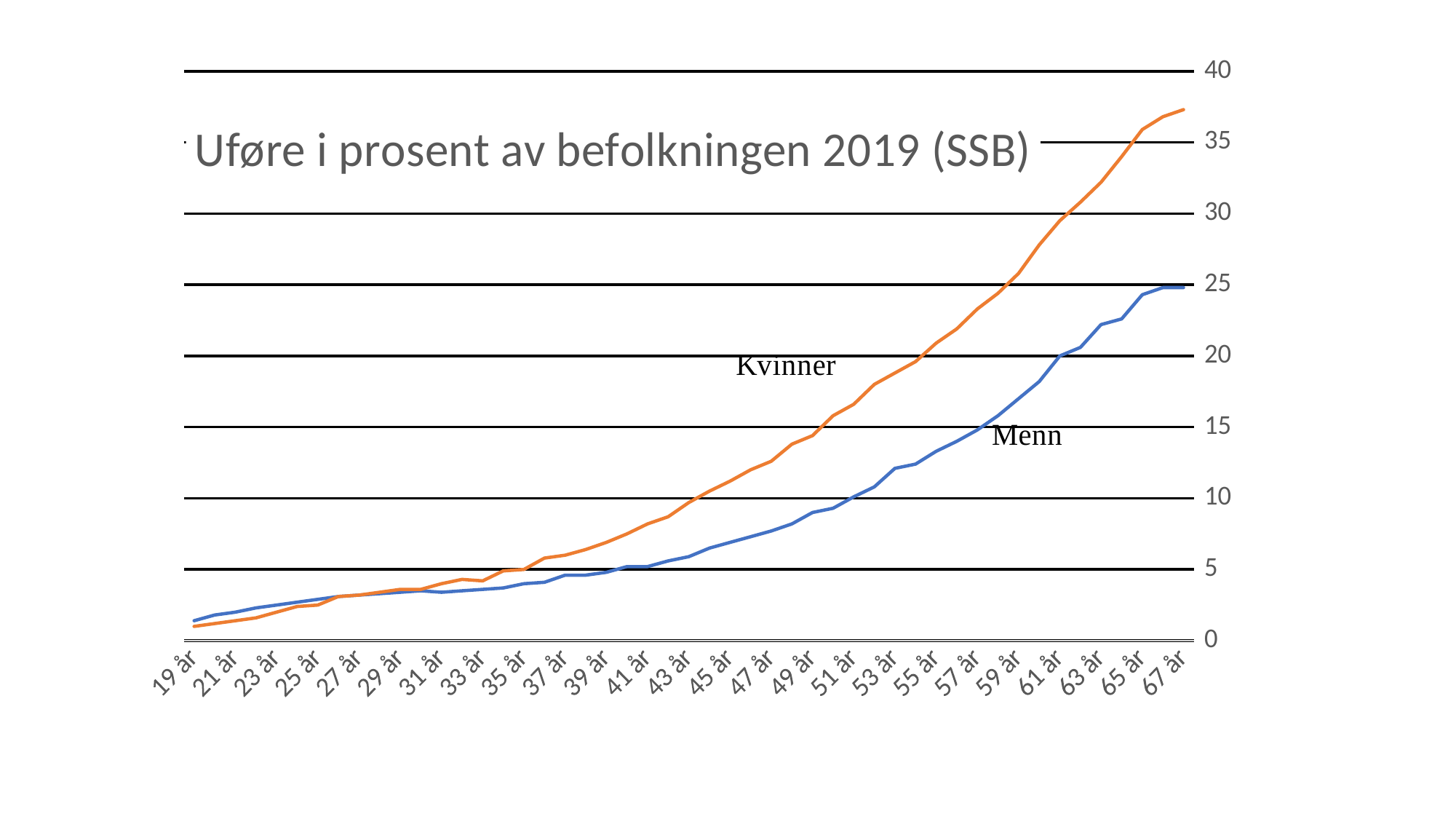
What is the title of the chart? Uføre i prosent av befolkningen 2019 (SSB) What kind of chart is shown on the slide? line chart Is the value for Menn at 67 år greater or less than 20? greater Is the value for Kvinner at 63 år greater or less than 30? greater How many age labels are shown on the x axis? 25 Is the value for Kvinner at 67 år greater or less than 35? greater Do the values for Kvinner rise or fall as age increases along the x axis? rise How many series are plotted in the chart? 2 Which series is drawn in orange? Kvinner At 67 år, which series has the higher value, Kvinner or Menn? Kvinner